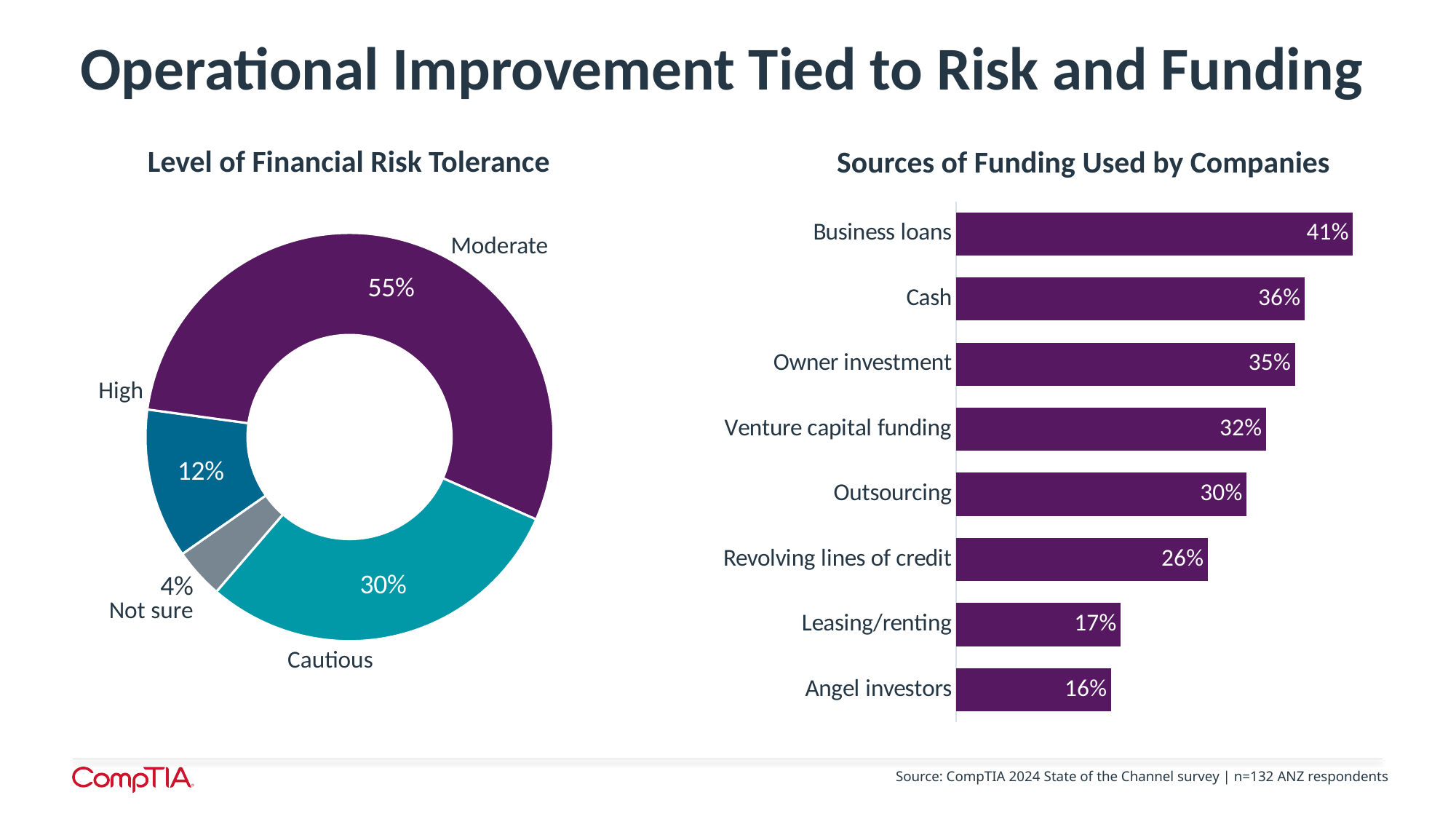
In the 'Level of Financial Risk Tolerance' chart, what percentage is shown for Moderate? 55% In the 'Sources of Funding Used by Companies' chart, what is the value for Outsourcing? 30% In the 'Level of Financial Risk Tolerance' chart, what is the difference between the Cautious and High shares? 18% In the 'Sources of Funding Used by Companies' chart, which is larger: Venture capital funding or Revolving lines of credit? Venture capital funding What kind of chart is the 'Level of Financial Risk Tolerance' chart? Doughnut chart How many categories are shown in the 'Level of Financial Risk Tolerance' chart? 4 How many funding sources are listed in the 'Sources of Funding Used by Companies' chart? 8 In the 'Sources of Funding Used by Companies' chart, which source has the lowest value? Angel investors What kind of chart is the 'Sources of Funding Used by Companies' chart? Bar chart In the 'Sources of Funding Used by Companies' chart, what is the difference between Business loans and Cash? 5% In the 'Sources of Funding Used by Companies' chart, which source has the highest value? Business loans In the 'Level of Financial Risk Tolerance' chart, which category has the smallest share? Not sure